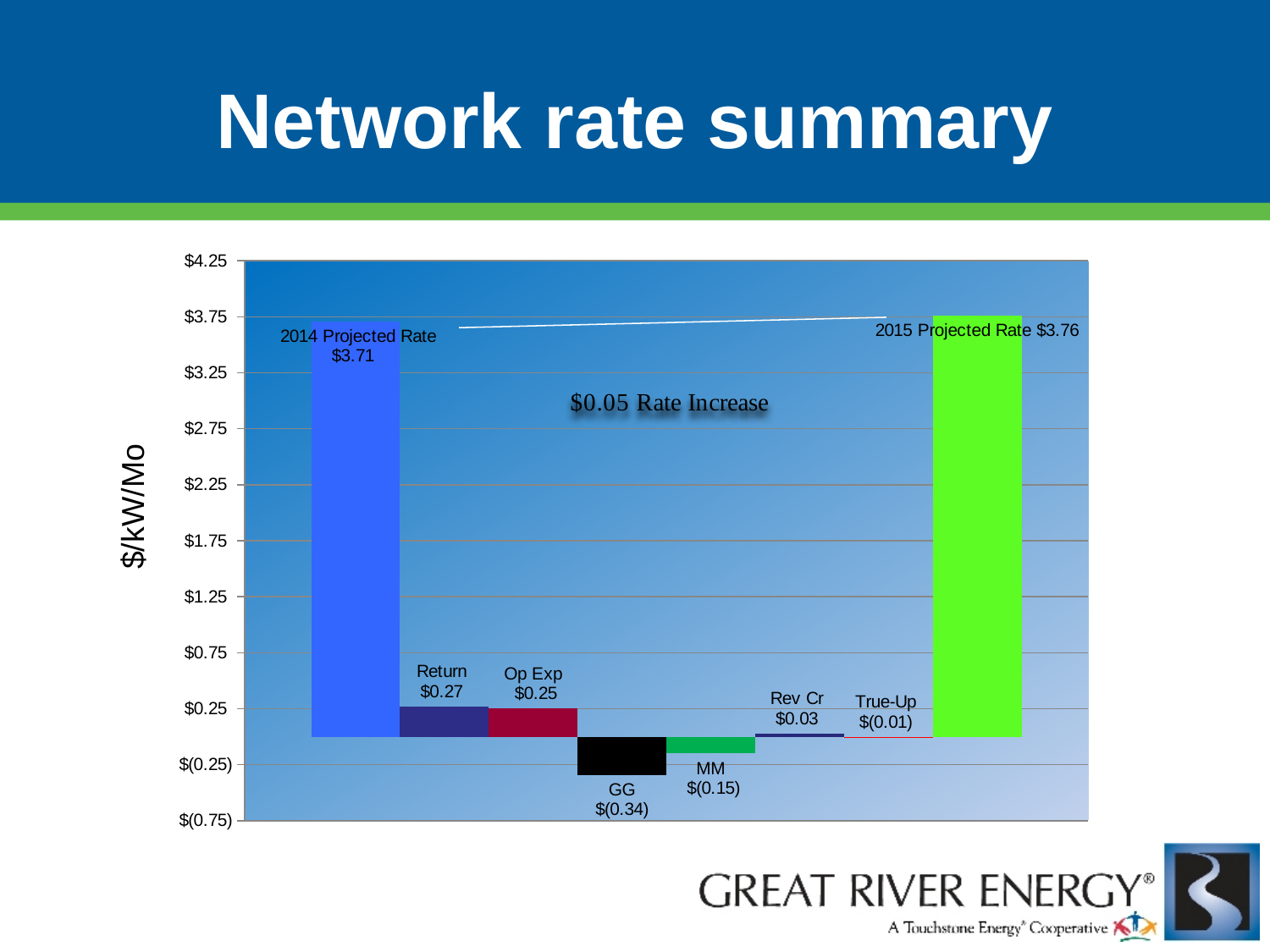
What is the label on the vertical axis of the chart? $/kW/Mo How many bars are plotted on the chart? 8 What value is labelled for GG? $(0.34) What value is labelled for True-Up? $(0.01) Which bar has the highest value on the chart? 2015 Projected Rate Which is larger, the value for Return or the value for Op Exp? Return Which bar has the lowest (most negative) value on the chart? GG What value is labelled for MM? $(0.15) What is the difference between the 2015 Projected Rate and the 2014 Projected Rate? $0.05 What is the value shown for the 2014 Projected Rate? $3.71 What value is labelled for Return? $0.27 What is the value shown for the 2015 Projected Rate? $3.76